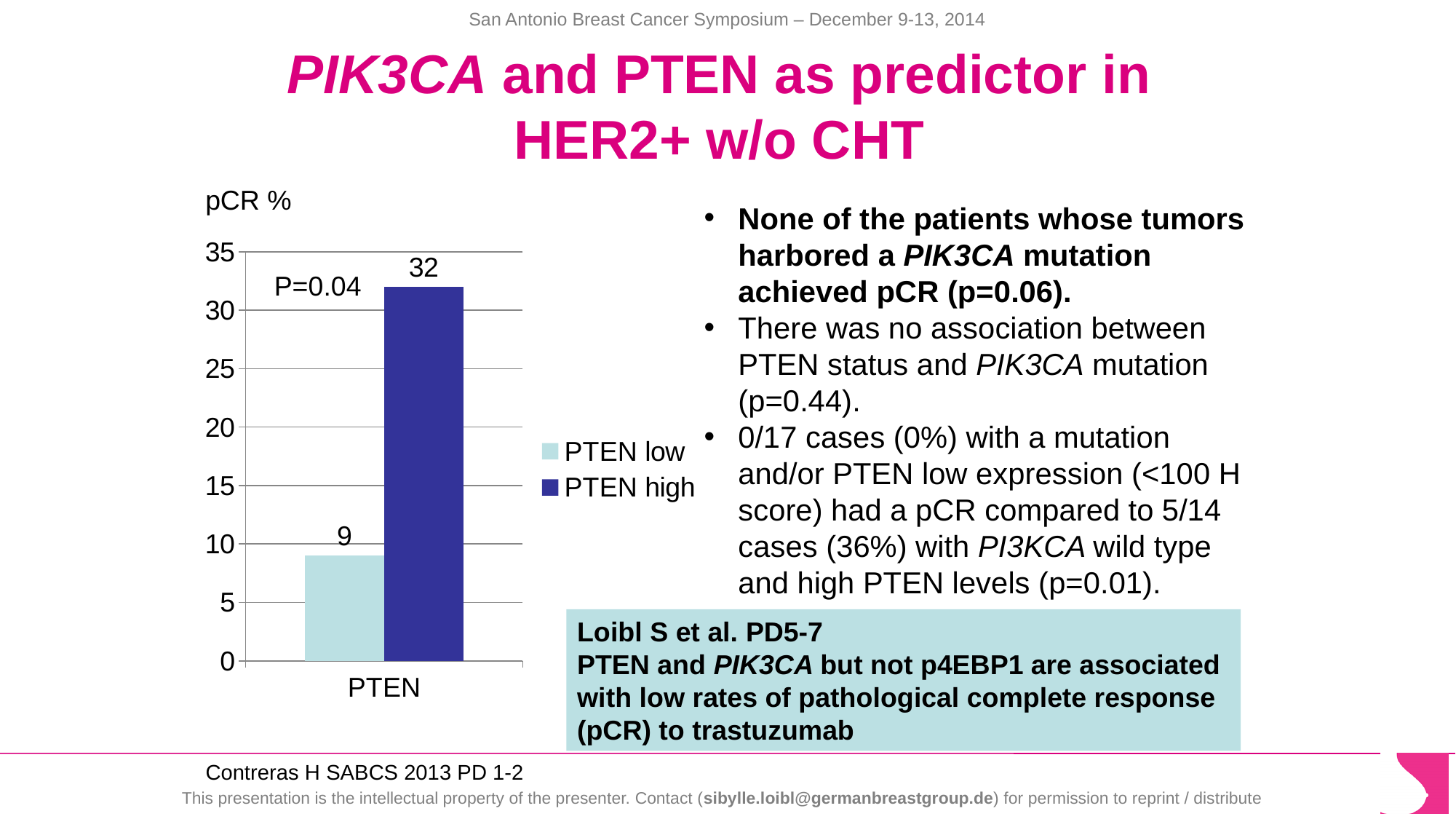
What is the pCR % for PTEN high? 32 What is the pCR % for PTEN low? 9 What is the difference in pCR % between PTEN high and PTEN low? 23 Is the pCR % for PTEN high greater or less than 30? greater What is the maximum value shown on the y axis of the chart? 35 What is the category label on the x axis of the chart? PTEN Which series has the higher pCR %, PTEN low or PTEN high? PTEN high What P value is printed on the chart? P=0.04 How many series does the chart legend list? 2 Which series has the lowest pCR %? PTEN low What type of chart is shown on the slide? Bar chart Is the pCR % for PTEN low greater or less than 10? less